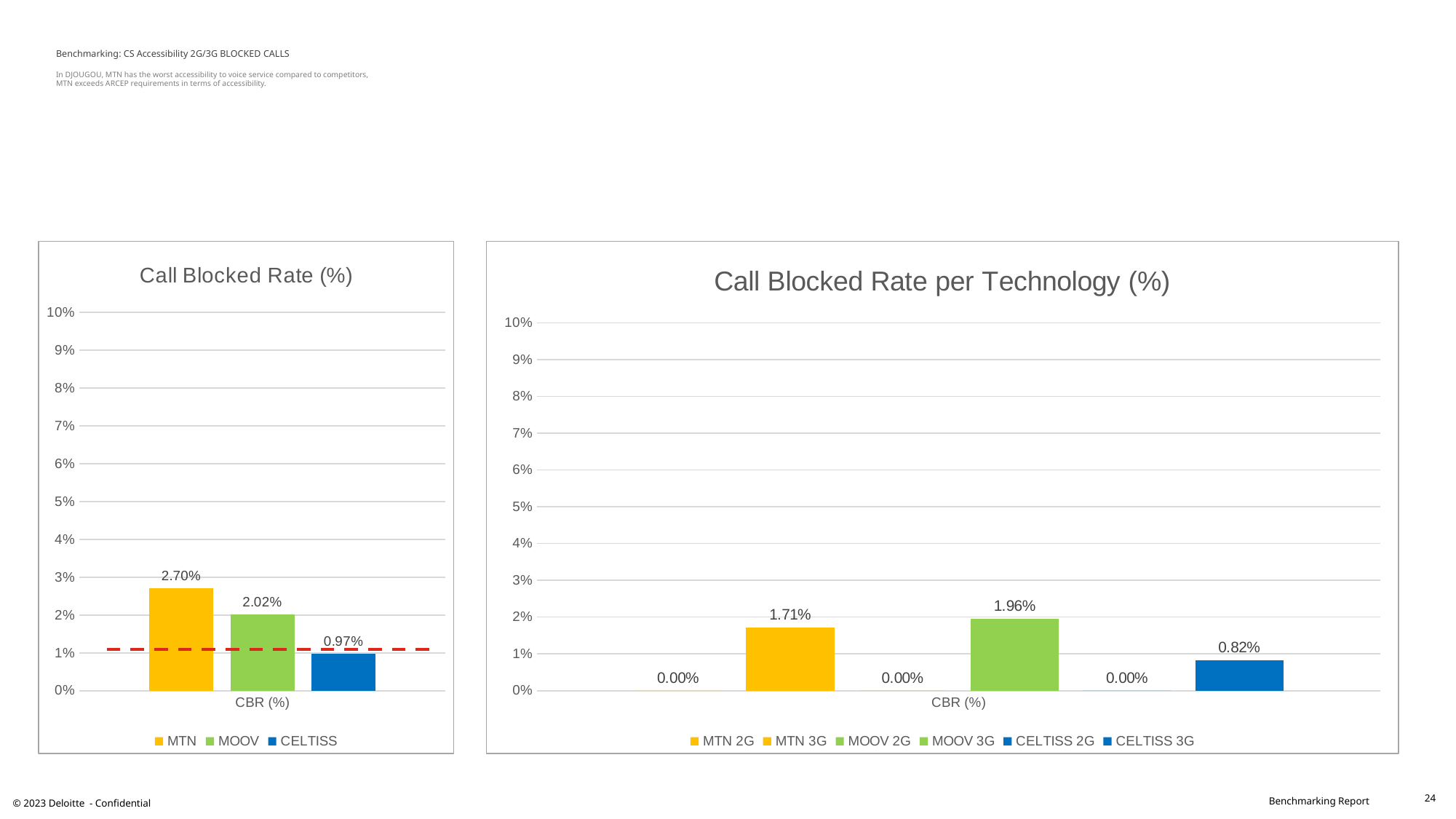
In the 'Call Blocked Rate per Technology (%)' chart, how many series does the legend list? 6 In the 'Call Blocked Rate (%)' chart, which operator has the lowest call blocked rate? CELTISS In the 'Call Blocked Rate per Technology (%)' chart, what is the value for MOOV 3G? 1.96% In the 'Call Blocked Rate (%)' chart, which operator has the highest call blocked rate? MTN In the 'Call Blocked Rate per Technology (%)' chart, what is the value for CELTISS 3G? 0.82% In the 'Call Blocked Rate per Technology (%)' chart, which is larger, MTN 3G or MOOV 3G? MOOV 3G In the 'Call Blocked Rate (%)' chart, what is the value for CELTISS? 0.97% In the 'Call Blocked Rate (%)' chart, what is the value for MTN? 2.70% In the 'Call Blocked Rate per Technology (%)' chart, what is the value for MTN 2G? 0.00% In the 'Call Blocked Rate (%)' chart, what is the difference between the MTN and MOOV values? 0.68% In the 'Call Blocked Rate (%)' chart, how many series does the legend list? 3 What kind of chart is the 'Call Blocked Rate per Technology (%)' chart? Bar chart